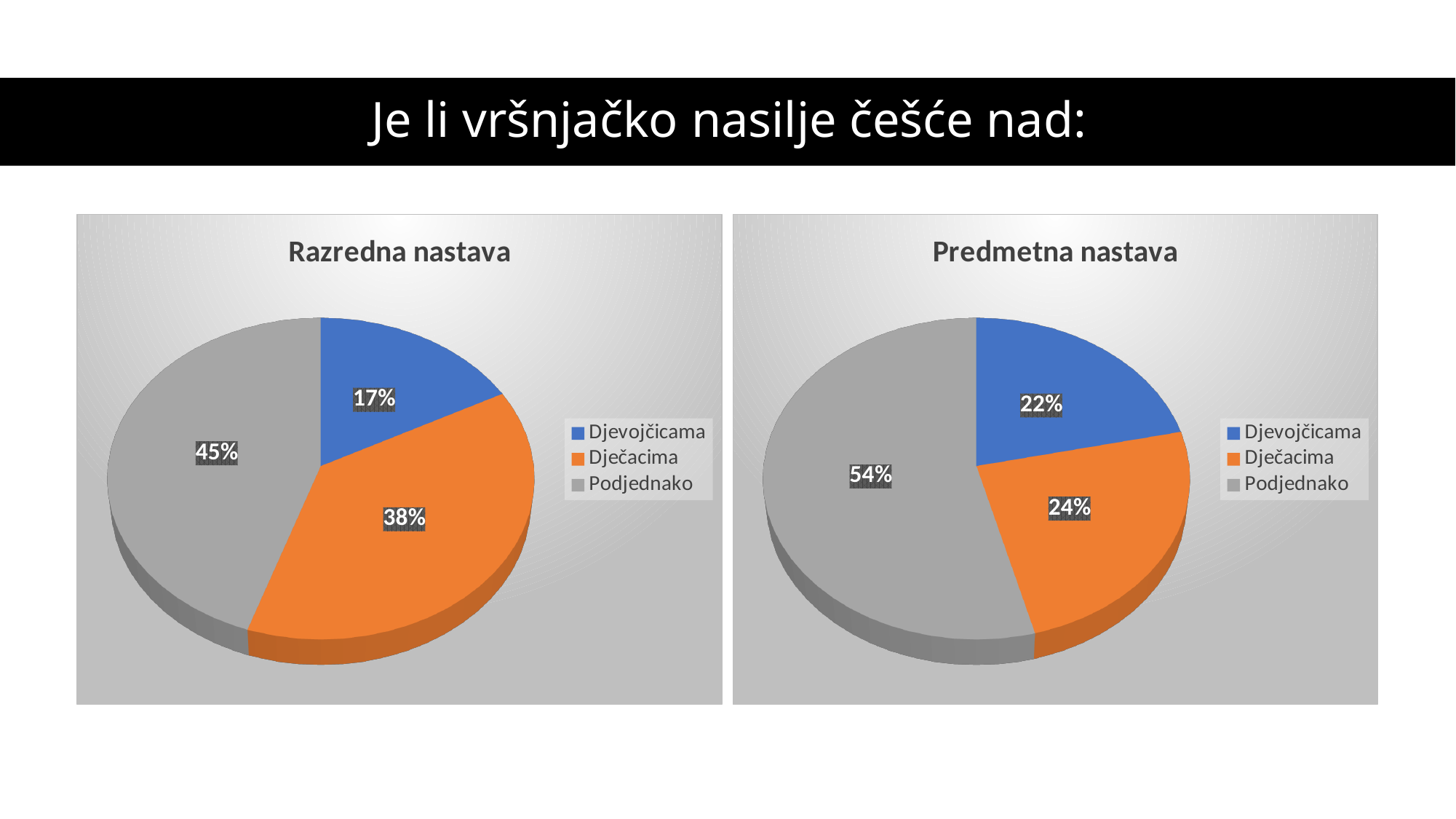
In the 'Razredna nastava' chart, what is the difference between the Dječacima and Djevojčicama shares? 21% In the 'Razredna nastava' chart, what colour represents Dječacima? Orange In the 'Razredna nastava' chart, what percentage is shown for Dječacima? 38% In the 'Predmetna nastava' chart, what is the difference between the Podjednako and Dječacima shares? 30% In the 'Predmetna nastava' chart, what percentage is shown for Podjednako? 54% How many categories does the 'Predmetna nastava' chart have? 3 In the 'Predmetna nastava' chart, which category has the smallest share? Djevojčicama What type of chart is the 'Razredna nastava' chart? Pie chart In the 'Predmetna nastava' chart, what percentage is shown for Dječacima? 24% In the 'Razredna nastava' chart, which category has the largest share? Podjednako Which chart shows a larger share for Djevojčicama, 'Razredna nastava' or 'Predmetna nastava'? Predmetna nastava In the 'Razredna nastava' chart, what percentage is shown for Djevojčicama? 17%